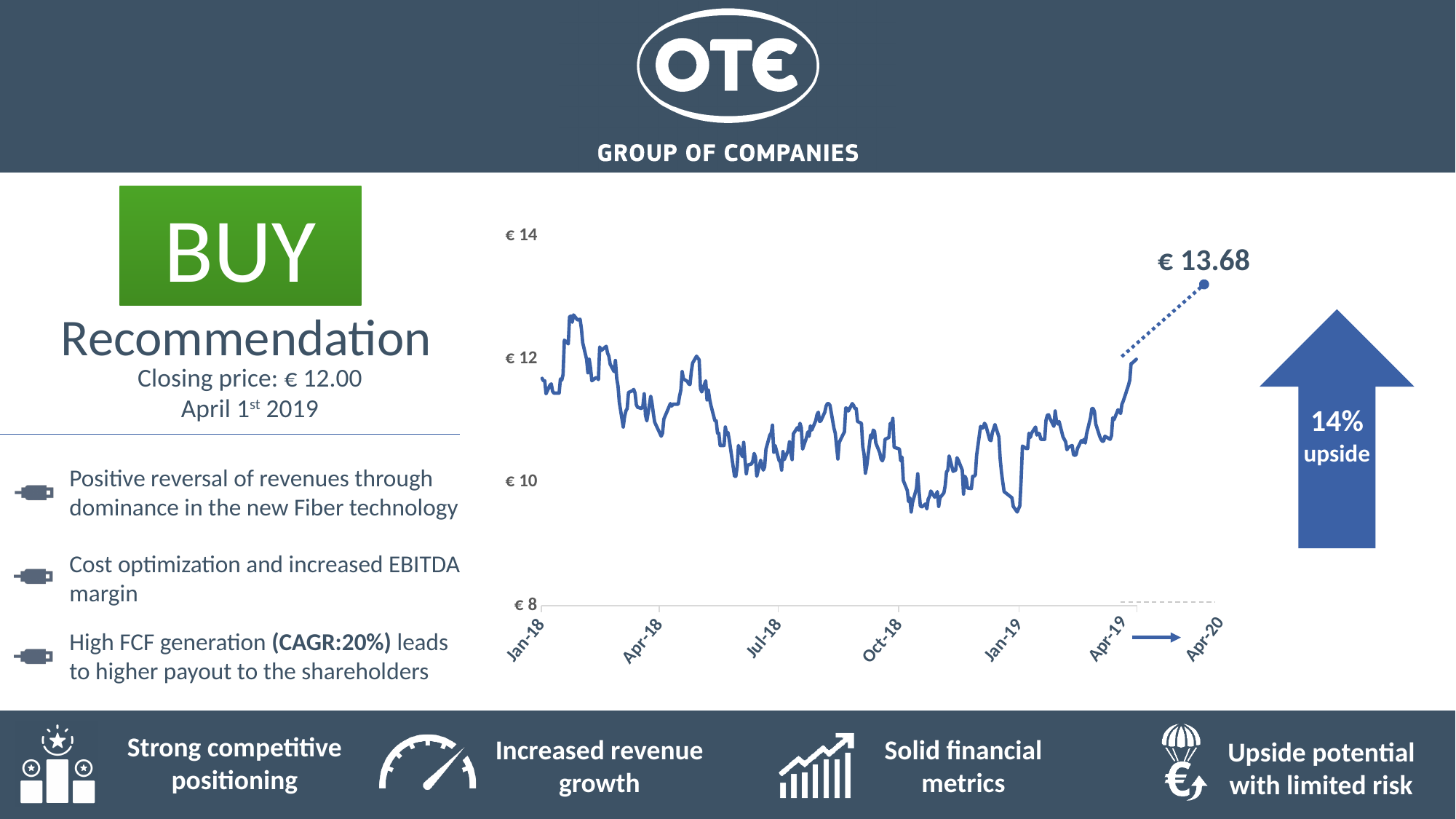
What is the projected price labelled at the end of the dotted line for Apr-20? € 13.68 What is the highest tick value shown on the y axis of the chart? € 14 What is the lowest tick value shown on the y axis of the chart? € 8 How many date labels are shown on the x axis of the chart? 7 Is the value at Jan-18 greater or less than 12? less Is the projected value for Apr-20 greater or less than 14? less Is the projected Apr-20 value higher or lower than the value at Apr-19? higher What upside percentage is shown in the arrow next to the chart? 14% Is the value at Jan-18 greater or less than 10? greater Does the line rise or fall between Jan-19 and Apr-19? rise What is the difference between the projected price of € 13.68 and the closing price of € 12.00? € 1.68 What kind of chart is shown on the slide? line chart